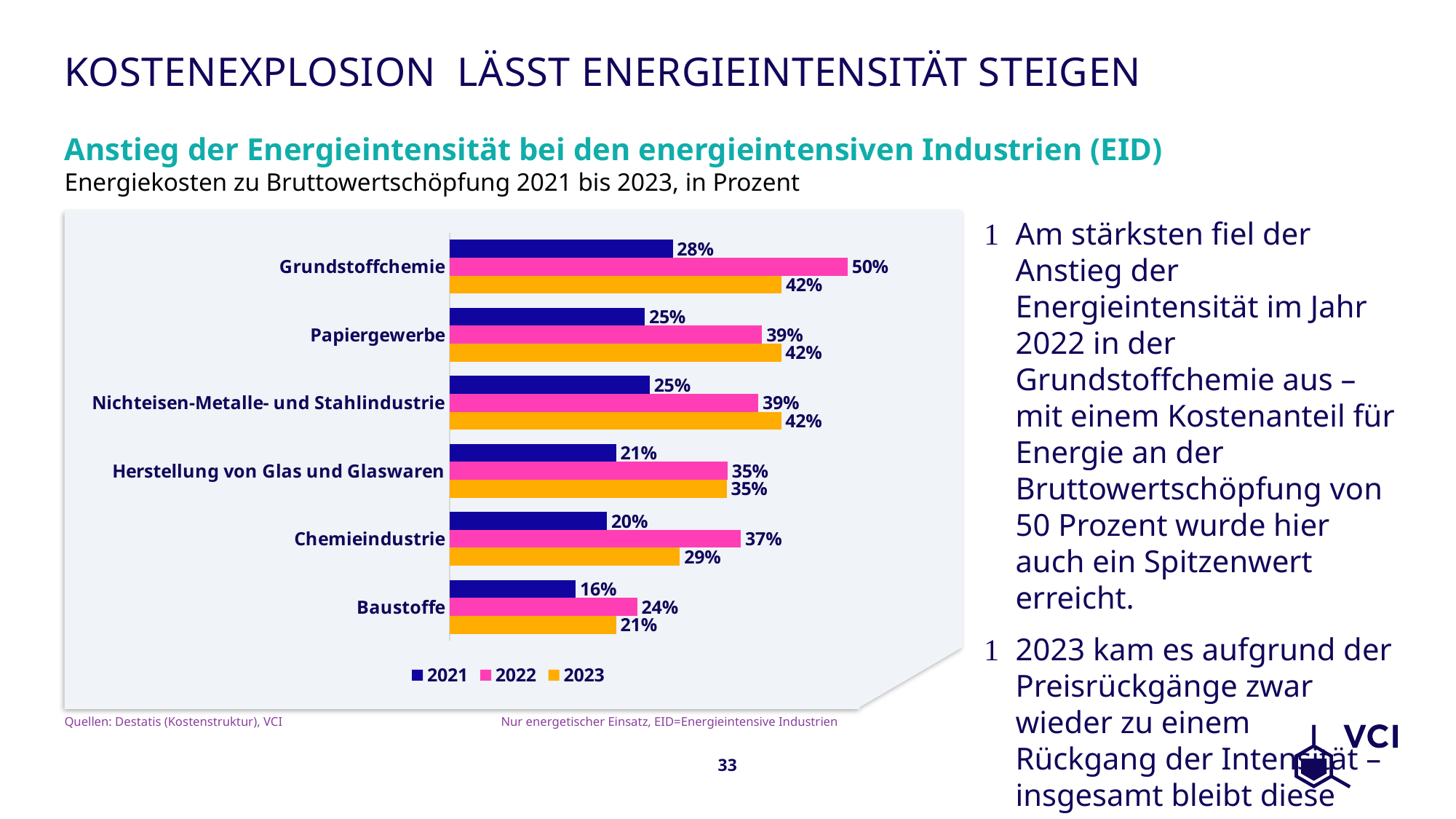
Which colour represents the 2023 series in the legend? Orange How many series does the legend list? 3 Which category has the highest value in 2022? Grundstoffchemie What is the value for Grundstoffchemie in 2022? 50% What is the value for Chemieindustrie in 2023? 29% What is the value for Baustoffe in 2021? 16% Which is larger for Chemieindustrie: the 2022 value or the 2023 value? 2022 What is the difference between the 2022 and 2021 values for Grundstoffchemie? 22 percentage points What is the difference between the 2023 values for Papiergewerbe and Baustoffe? 21 percentage points Which category has the lowest value in 2021? Baustoffe How many categories are shown on the chart? 6 What kind of chart is shown on the slide? Bar chart